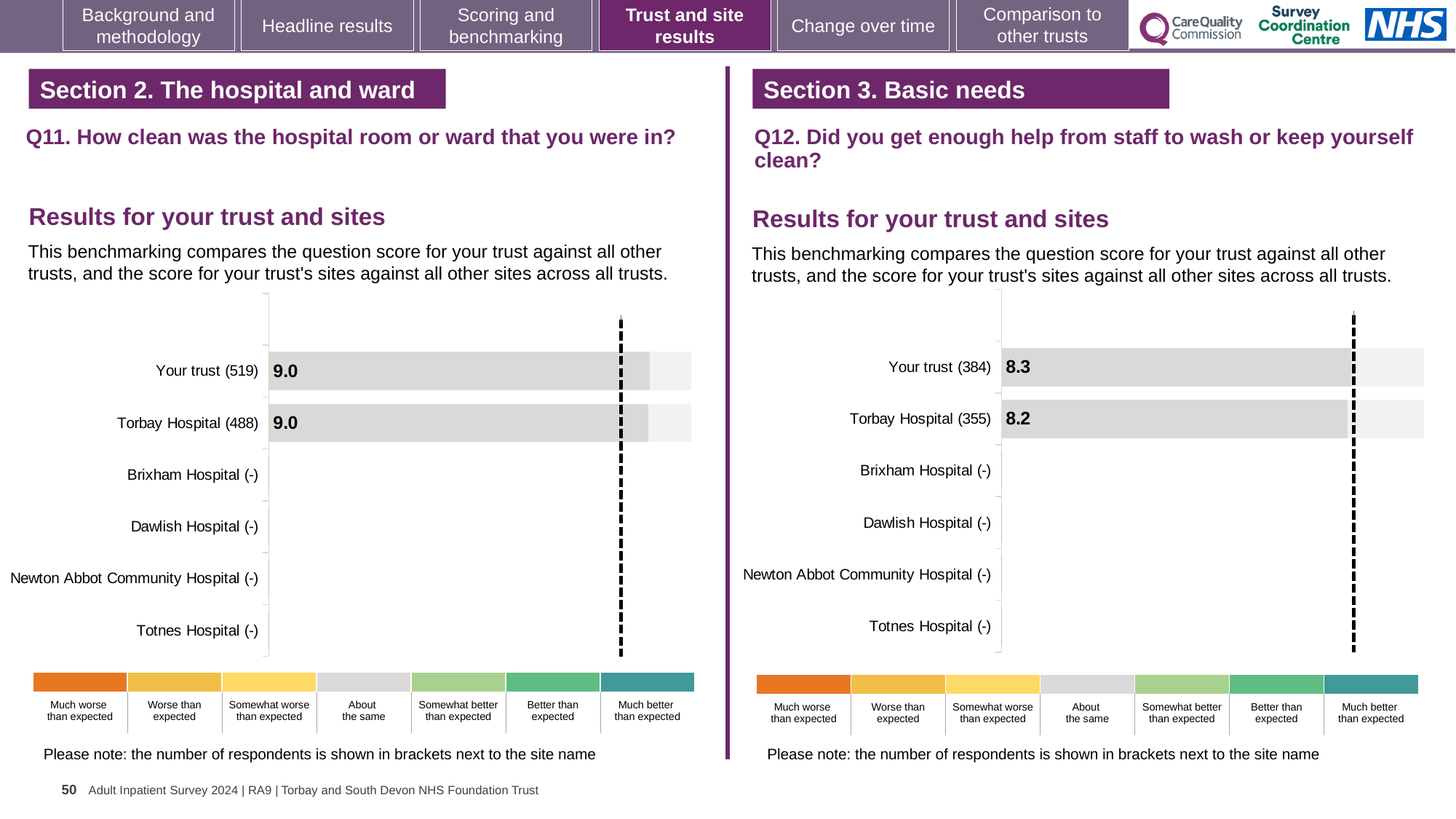
In the Q11 chart (left), what is the score for Your trust (519)? 9.0 How many categories (trust and sites) are listed on the Q11 chart (left)? 6 In the Q12 chart (right), how many respondents are shown in brackets for Your trust? 384 In the Q12 chart (right), what is the score for Torbay Hospital (355)? 8.2 What kind of chart is used for the Q12 results (right)? Bar chart In the Q12 chart (right), what is the score for Your trust (384)? 8.3 In the Q11 chart (left), what is the score for Torbay Hospital (488)? 9.0 In the Q11 chart (left), what is the difference between the score for Your trust and the score for Torbay Hospital? 0.0 In the Q12 chart (right), which has the higher score, Your trust or Torbay Hospital? Your trust How many categories (trust and sites) are listed on the Q12 chart (right)? 6 In the Q11 chart (left), how many respondents are shown in brackets for Torbay Hospital? 488 In the Q12 chart (right), what is the difference between the score for Your trust and the score for Torbay Hospital? 0.1